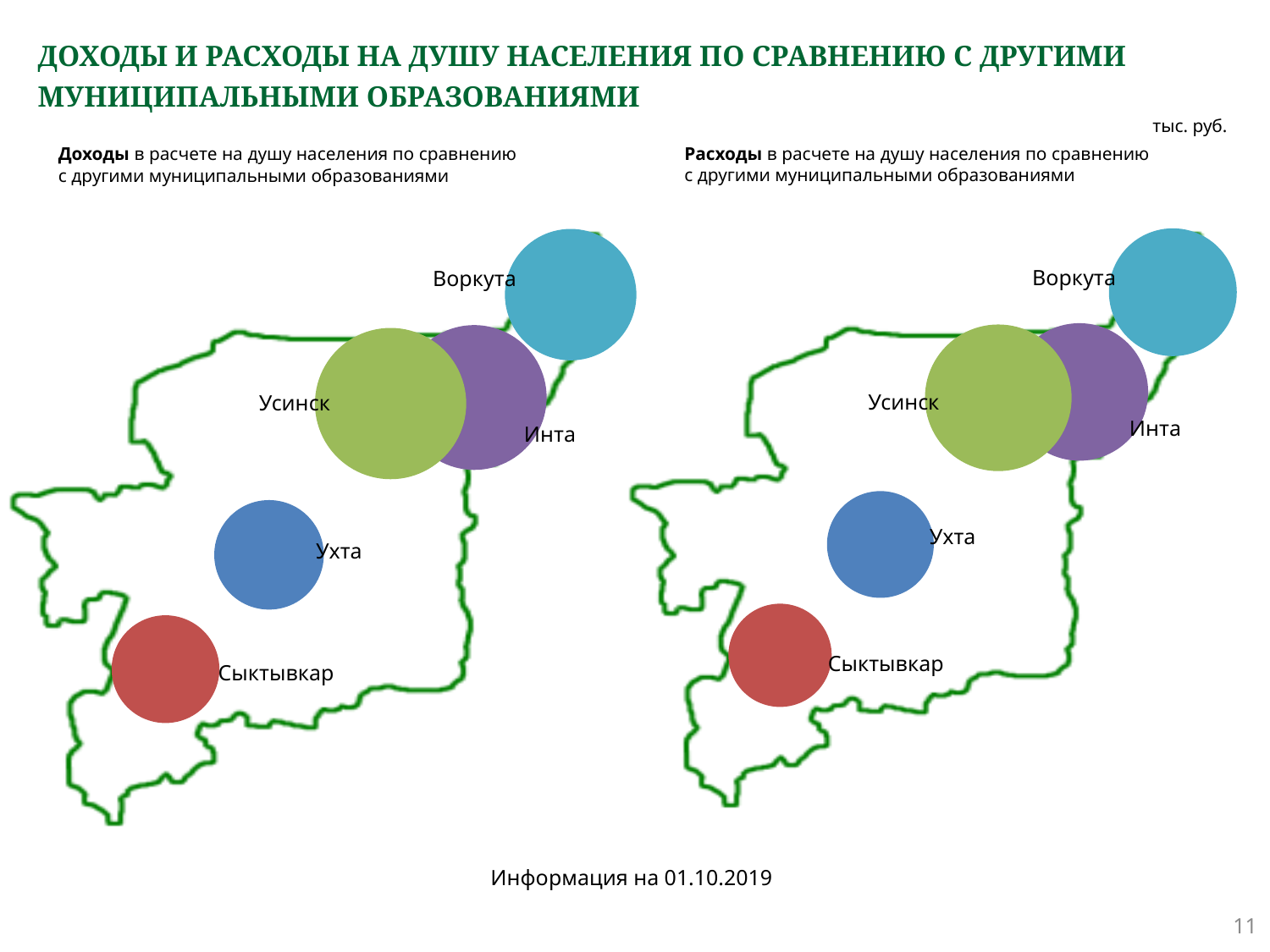
How many municipalities are shown as bubbles on the right chart (Расходы)? 5 On the left chart (Доходы), which municipality has the largest bubble? Усинск What kind of chart is used on the left (Доходы) to compare municipalities? Bubble chart What kind of chart is used on the right (Расходы) to compare municipalities? Bubble chart On the right chart (Расходы), which bubble is larger: Воркута or Ухта? Воркута What colour is the bubble for Сыктывкар on both charts? Red On the left chart (Доходы), which bubble is larger: Усинск or Сыктывкар? Усинск How many municipalities are shown as bubbles on the left chart (Доходы)? 5 On the right chart (Расходы), which municipality has the largest bubble? Усинск What unit is stated for the values on the slide? тыс. руб.